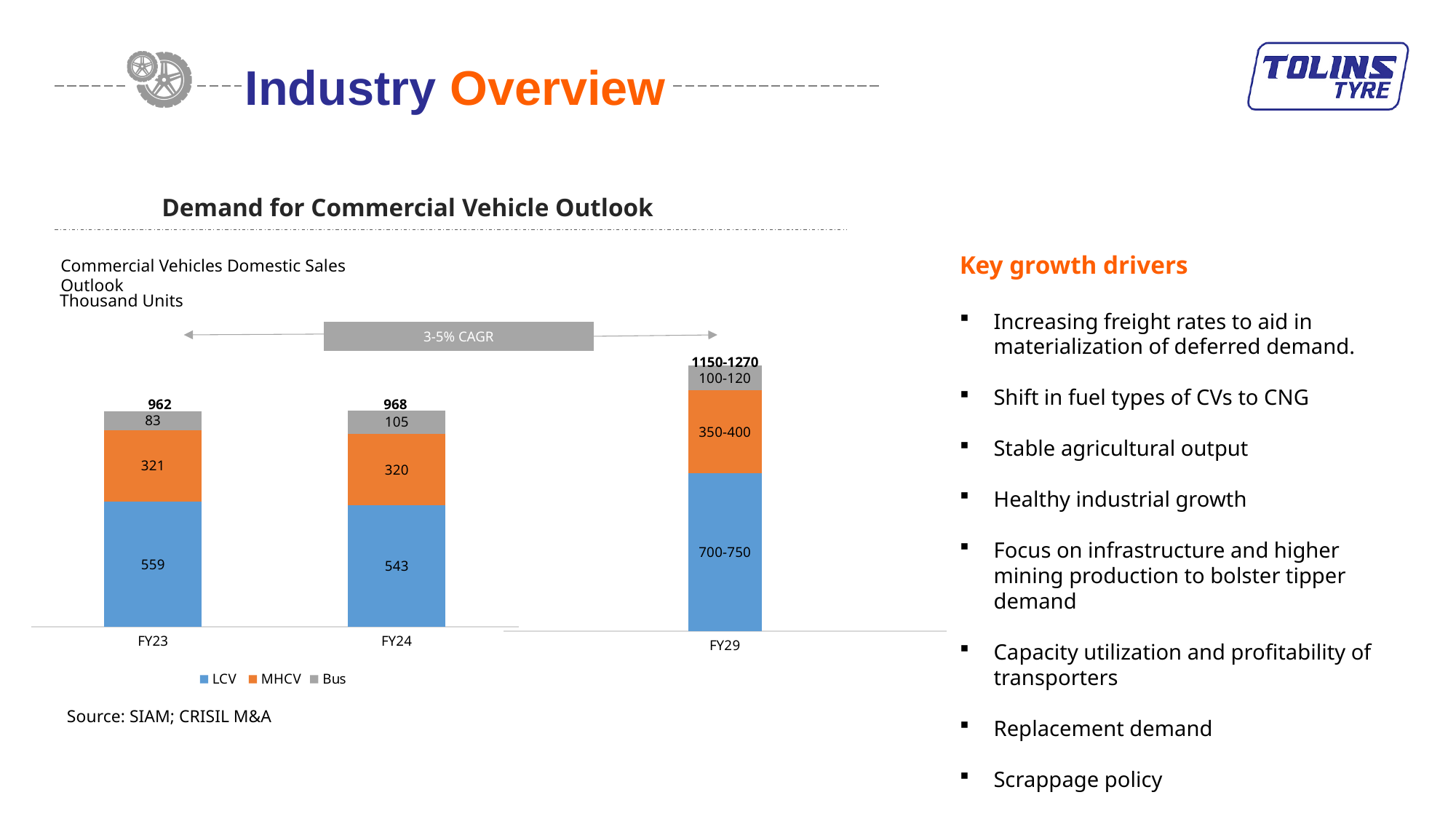
What is the Bus value for FY23? 83 What is the LCV value shown for FY29? 700-750 How many categories (fiscal years) are shown on the x axis? 3 What is the difference between the Bus values for FY24 and FY23? 22 What is the MHCV value for FY24? 320 Which is larger, the LCV value for FY23 or for FY24? FY23 What kind of chart is used to show the Commercial Vehicles Domestic Sales Outlook? Stacked bar chart What is the total shown above the FY24 stacked bar? 968 What CAGR is shown in the grey box above the bars? 3-5% CAGR What is the LCV value for FY23? 559 How many series does the legend list? 3 What is the total shown above the FY29 stacked bar? 1150-1270